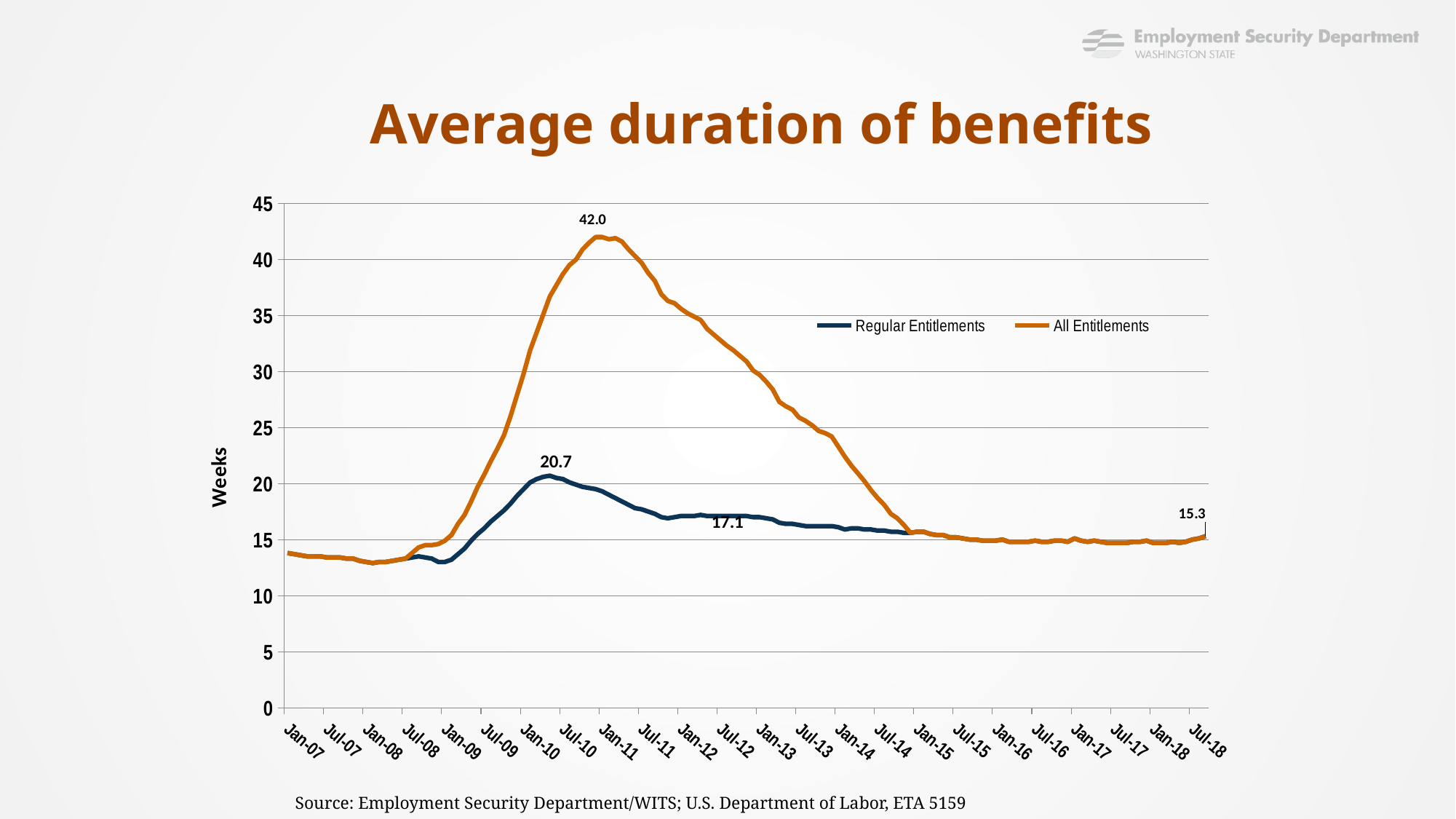
What kind of chart is shown on the slide? line chart What is the difference between the labeled peak of All Entitlements (42.0) and the labeled peak of Regular Entitlements (20.7)? 21.3 What is the peak value labeled on the Regular Entitlements line? 20.7 What value is labeled at the end of the chart at Jul-18? 15.3 How many series does the legend list? 2 What is the peak value labeled on the All Entitlements line? 42.0 Is the value for Regular Entitlements at Jan-07 greater or less than 15? less What is the label on the vertical axis? Weeks What is the difference between the two labeled values on the Regular Entitlements line, 20.7 and 17.1? 3.6 Does the All Entitlements line rise or fall between Jan-11 and Jul-14? fall Which series reaches the higher peak, Regular Entitlements or All Entitlements? All Entitlements